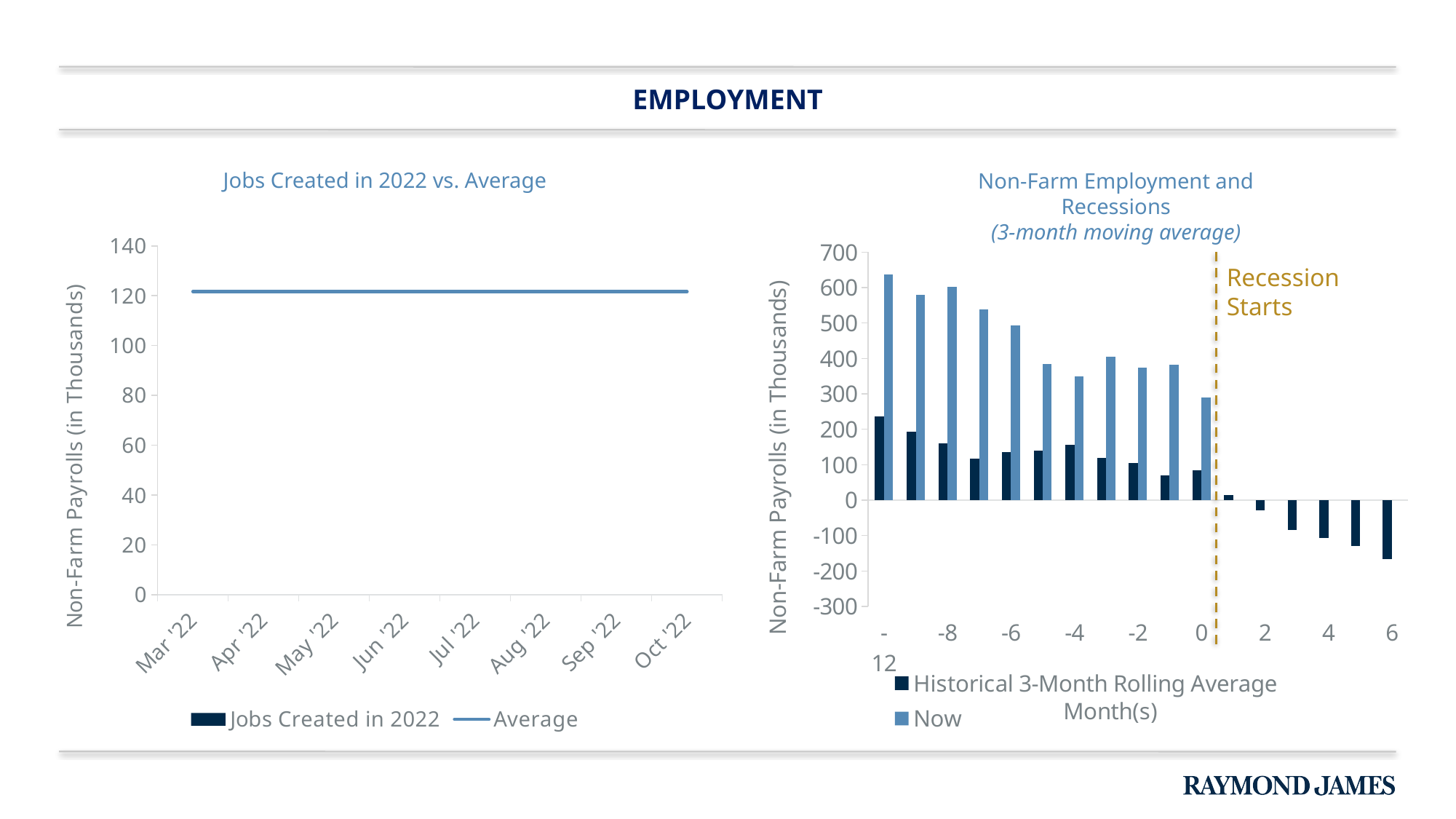
On the 'Jobs Created in 2022 vs. Average' chart, is the Average line greater or less than 100? greater On the 'Jobs Created in 2022 vs. Average' chart, is the Average line greater or less than 140? less On the 'Non-Farm Employment and Recessions' chart, what does the label next to the dashed vertical line say? Recession Starts On the 'Jobs Created in 2022 vs. Average' chart, how many series does the legend list? 2 On the 'Non-Farm Employment and Recessions' chart, is the 'Now' value at month -12 greater or less than 600? greater On the 'Non-Farm Employment and Recessions' chart, what kind of chart is it? bar chart On the 'Non-Farm Employment and Recessions' chart, at which month is the 'Historical 3-Month Rolling Average' series lowest? 6 On the 'Jobs Created in 2022 vs. Average' chart, how many months are shown on the x axis? 8 On the 'Non-Farm Employment and Recessions' chart, how many series does the legend list? 2 On the 'Non-Farm Employment and Recessions' chart, does the 'Historical 3-Month Rolling Average' series generally rise or fall from month -12 to month 6? fall On the 'Non-Farm Employment and Recessions' chart, at which month is the 'Now' series highest? -12